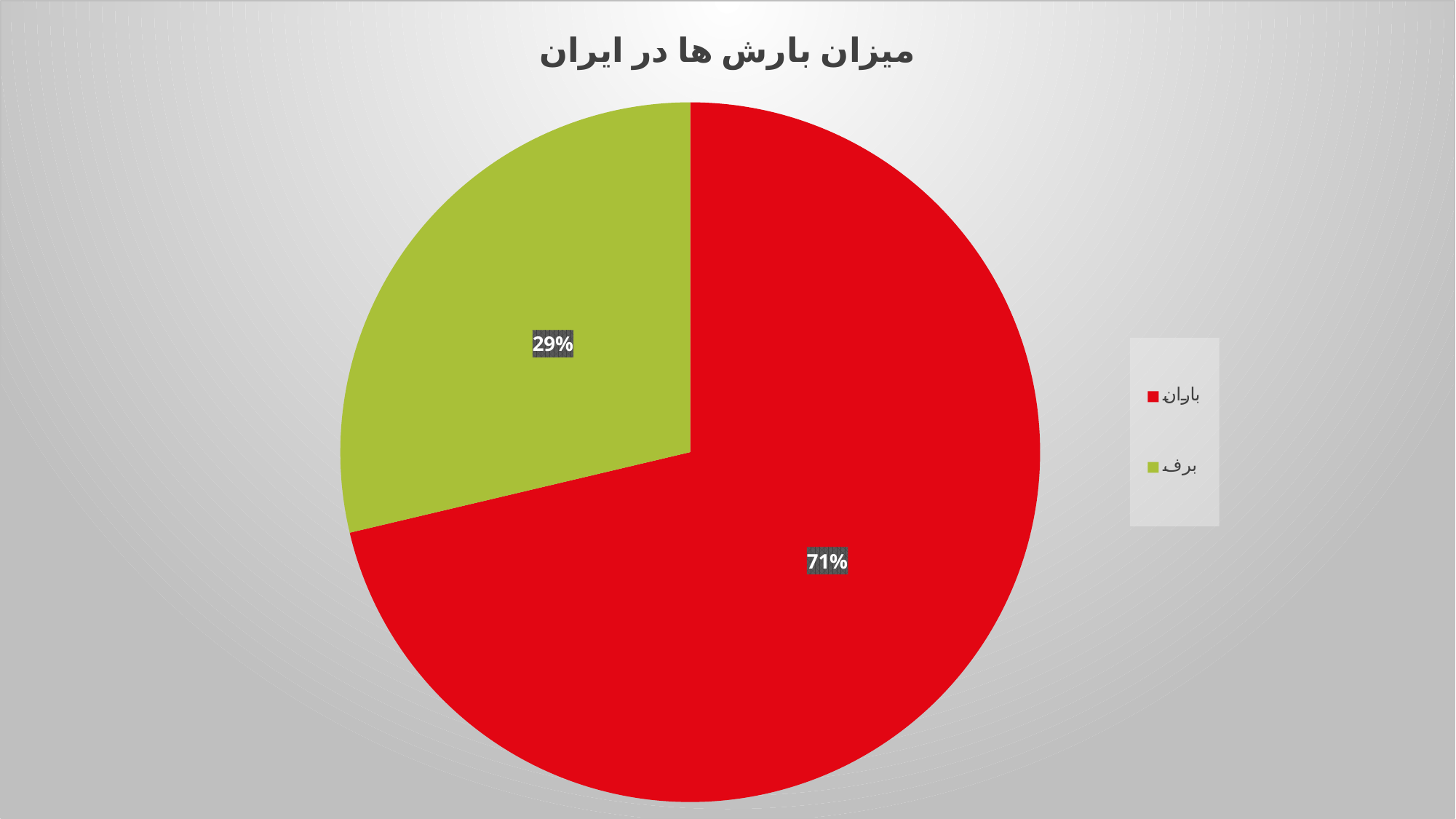
Which category has the largest slice of the pie? باران What is the difference in percentage points between the باران slice and the برف slice? 42 What is the title of the chart? میزان بارش ها در ایران How many entries does the legend list? 2 What share of the pie does برف (snow) take? 29% Which is larger, the slice for باران or the slice for برف? باران What share of the pie does باران (rain) take? 71% Which category has the smallest slice of the pie? برف Is the share for باران greater or less than 50%? greater How many slices does the pie chart have? 2 What colour is the slice for برف? Green What kind of chart is shown on the slide? Pie chart